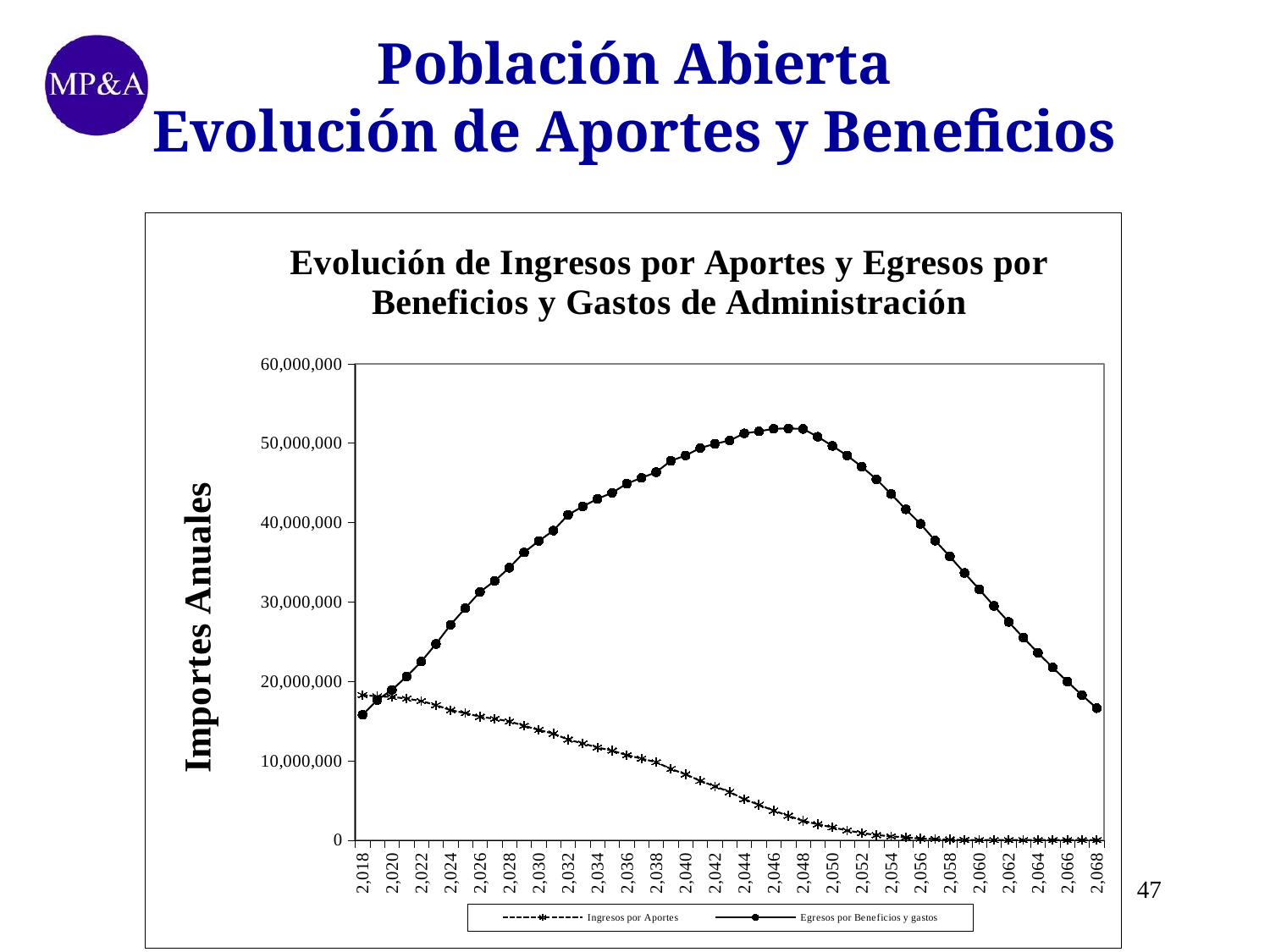
Is the value of Ingresos por Aportes in 2,060 greater or less than 10,000,000? less Does the Ingresos por Aportes series rise or fall from 2,018 to 2,068? fall What is the label on the vertical axis of the chart? Importes Anuales Is the value of Ingresos por Aportes in 2,018 greater or less than 20,000,000? less Is the value of Egresos por Beneficios y gastos in 2,068 greater or less than 20,000,000? less What kind of chart is shown on the slide? line chart How many series does the chart's legend list? 2 Does the Egresos por Beneficios y gastos series rise or fall between 2,018 and 2,046? rise What is the title of the chart? Evolución de Ingresos por Aportes y Egresos por Beneficios y Gastos de Administración In 2,040, which series has the higher value, Ingresos por Aportes or Egresos por Beneficios y gastos? Egresos por Beneficios y gastos